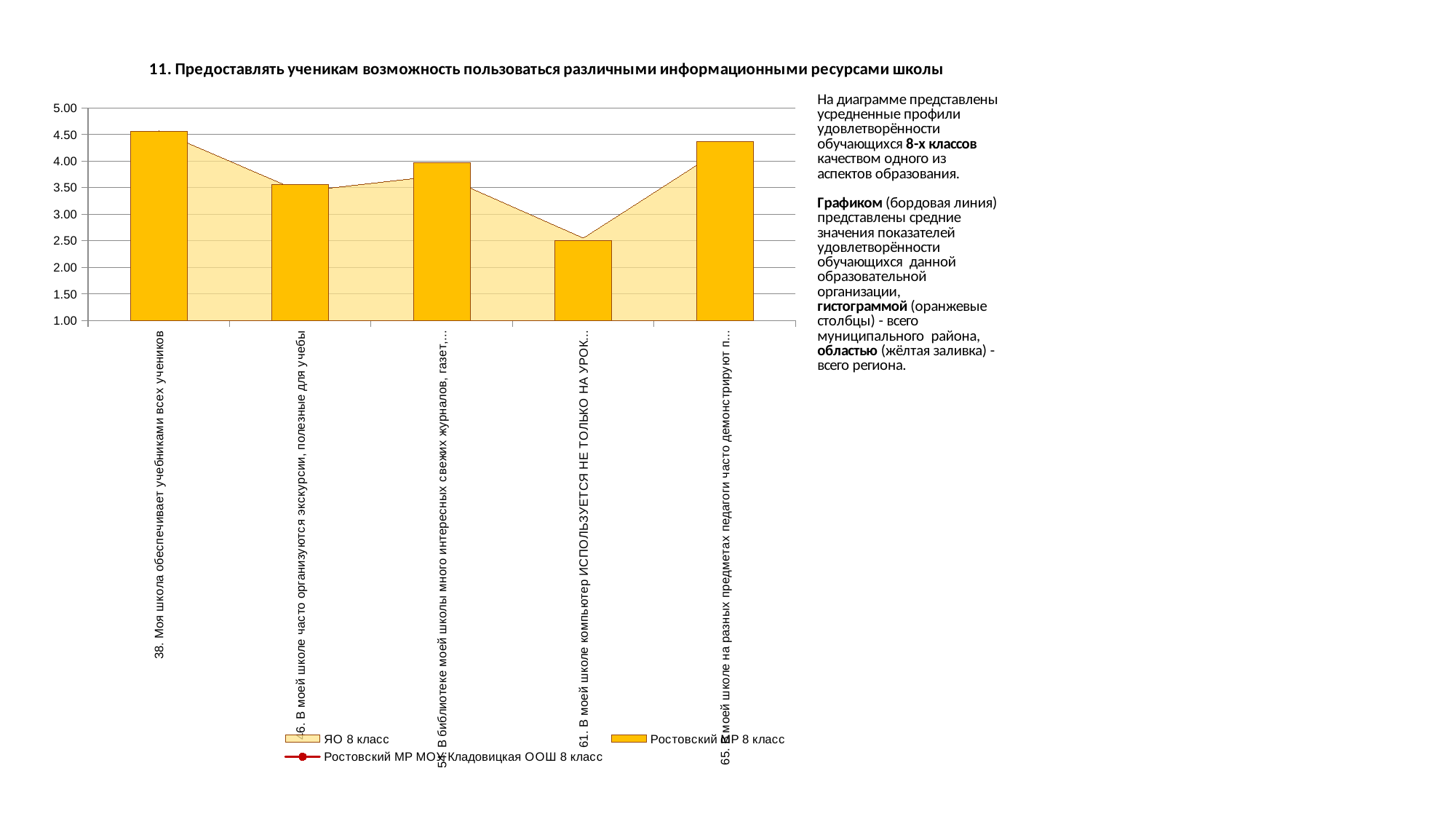
Which category has the highest bar for Ростовский МР 8 класс? 38. Моя школа обеспечивает учебниками всех учеников What is the title of the chart? 11. Предоставлять ученикам возможность пользоваться различными информационными ресурсами школы Is the Ростовский МР 8 класс value for category 46 greater or less than 3.00? greater What kind of chart is shown on the slide? Bar chart combined with an area chart Is the Ростовский МР 8 класс value for category 65 greater or less than 4.00? greater What colour represents the series Ростовский МР 8 класс in the legend? Orange Which is larger for Ростовский МР 8 класс: the value for category 38 or the value for category 61? Category 38 Is the Ростовский МР 8 класс value for category 61 greater or less than 3.00? less How many categories are shown on the x axis? 5 How many series does the legend list? 3 Which category has the lowest bar for Ростовский МР 8 класс? 61. В моей школе компьютер ИСПОЛЬЗУЕТСЯ НЕ ТОЛЬКО НА УРОК...